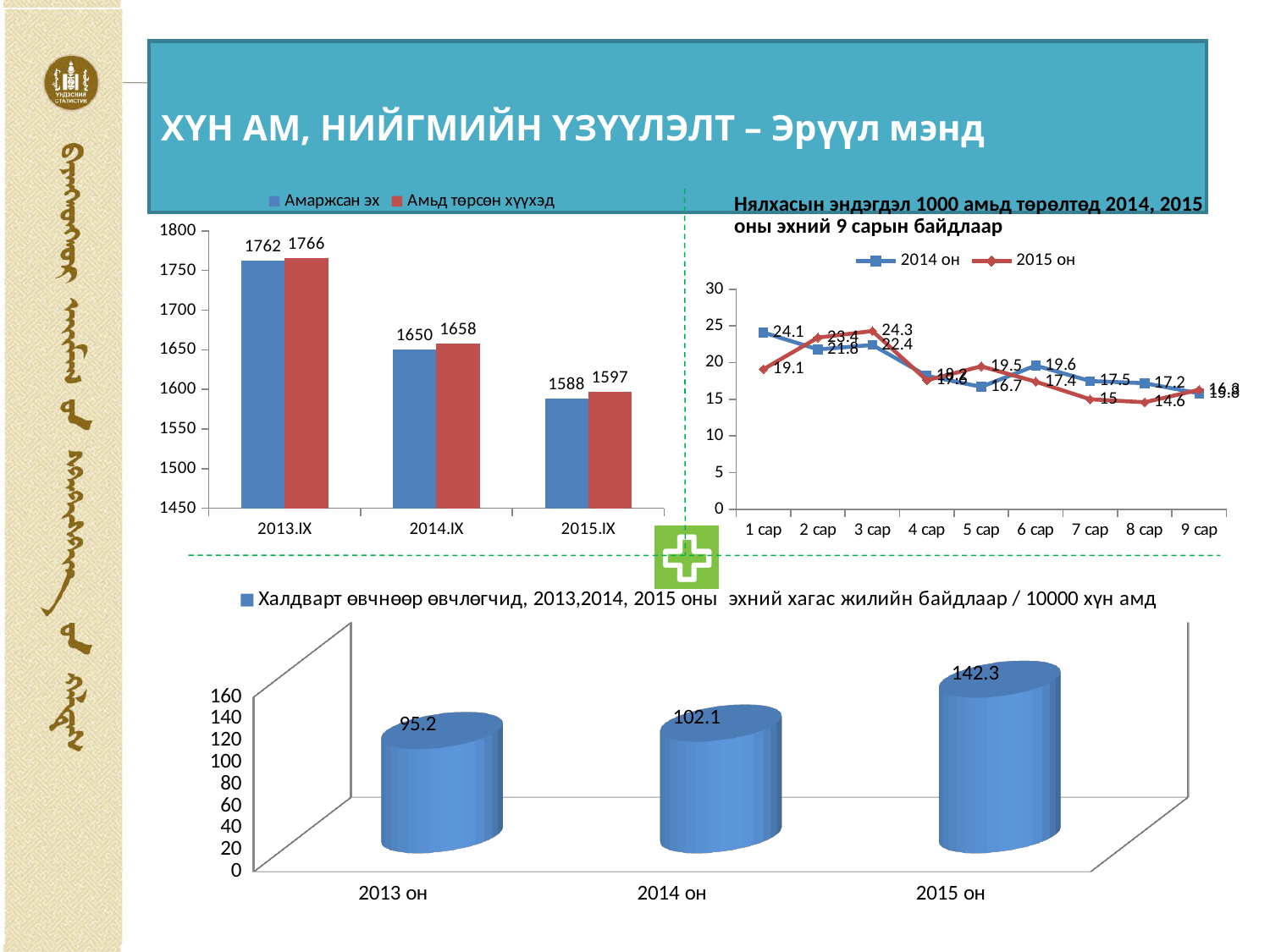
In the chart titled 'Нялхасын эндэгдэл 1000 амьд төрөлтөд 2014, 2015 оны эхний 9 сарын байдлаар', how many months are shown on the x axis? 9 In the top-left bar chart, which period has the lowest value for Амаржсан эх? 2015.IX In the bottom chart about Халдварт өвчнөөр өвчлөгчид, what is the value for 2015 он? 142.3 In the chart titled 'Нялхасын эндэгдэл 1000 амьд төрөлтөд 2014, 2015 оны эхний 9 сарын байдлаар', what is the value for 2014 он at 1 сар? 24.1 In the top-left bar chart, what is the value of Амьд төрсөн хүүхэд for 2015.IX? 1597 In the chart titled 'Нялхасын эндэгдэл 1000 амьд төрөлтөд 2014, 2015 оны эхний 9 сарын байдлаар', which series has the larger value at 3 сар, 2014 он or 2015 он? 2015 он In the bottom chart about Халдварт өвчнөөр өвчлөгчид, what is the difference between the values for 2014 он and 2013 он? 6.9 In the top-left bar chart, what is the difference between Амьд төрсөн хүүхэд and Амаржсан эх for 2014.IX? 8 In the chart titled 'Нялхасын эндэгдэл 1000 амьд төрөлтөд 2014, 2015 оны эхний 9 сарын байдлаар', what is the value for 2015 он at 8 сар? 14.6 In the top-left bar chart, do the values for Амаржсан эх rise or fall from 2013.IX to 2015.IX? fall In the top-left bar chart, how many series does the legend list? 2 In the top-left bar chart, what is the value of Амаржсан эх for 2013.IX? 1762